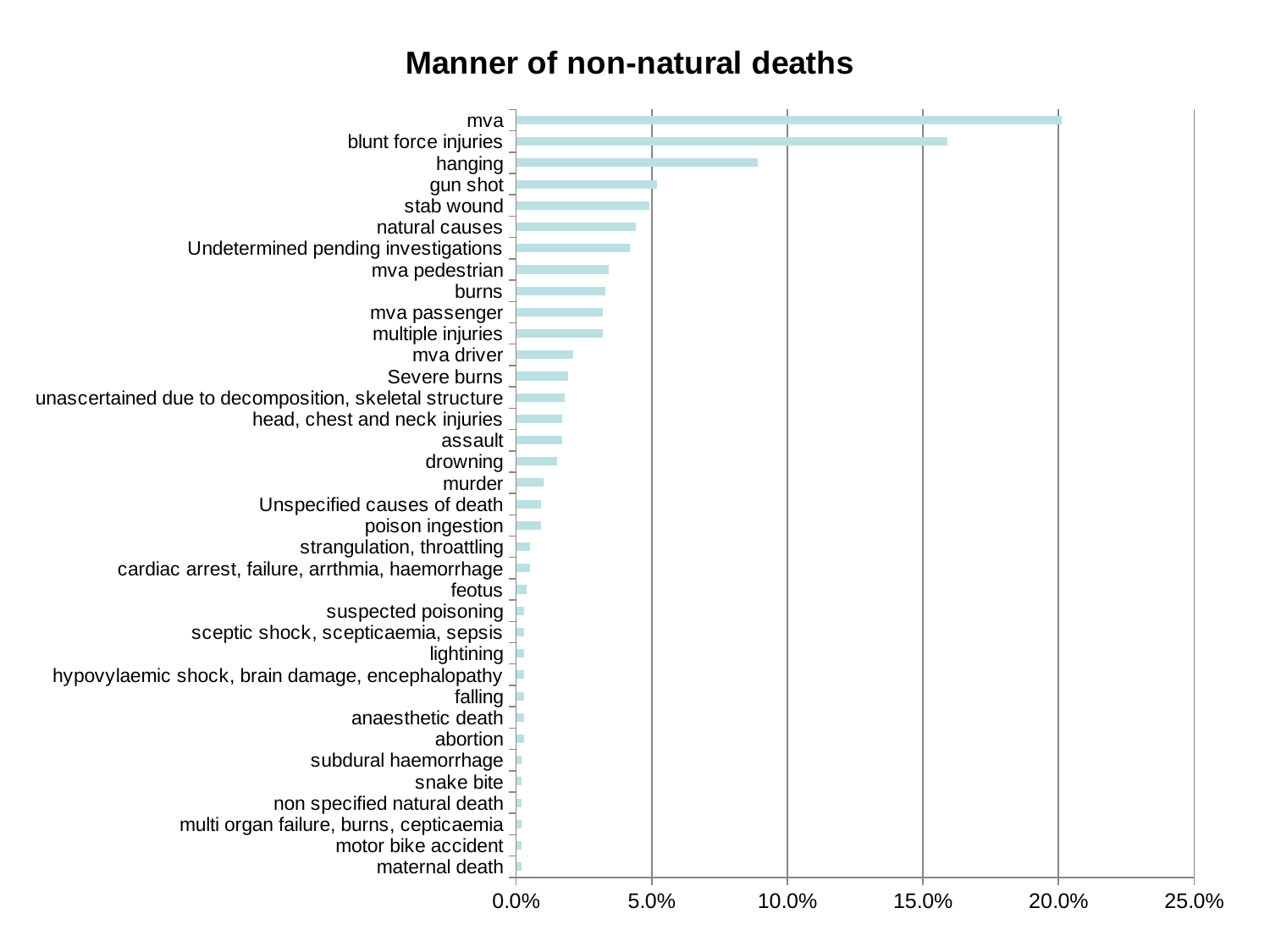
What is the title of the chart? Manner of non-natural deaths Is the value for mva pedestrian greater or less than 5.0%? less Which manner of death has the highest value in the chart? mva What is the highest value shown on the horizontal axis? 25.0% What kind of chart is shown on the slide? bar chart Is the value for hanging greater or less than 10.0%? less How many categories are plotted in the chart? 36 Is the value for blunt force injuries greater or less than 15.0%? greater Which is larger, the value for mva or the value for blunt force injuries? mva Which is larger, the value for hanging or the value for gun shot? hanging